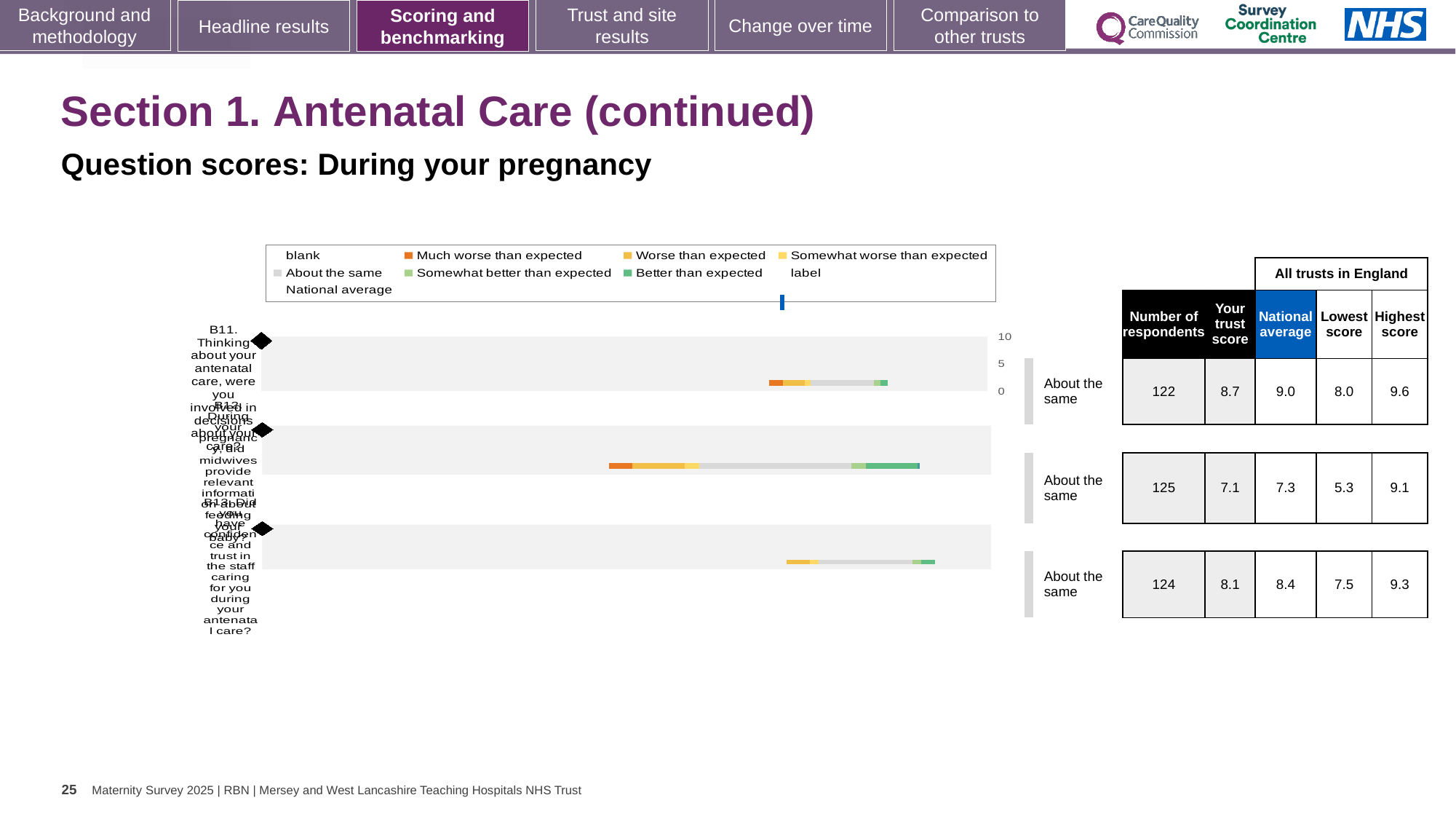
What is the difference between the highest score and the lowest score for question B11? 1.6 What is the national average for question B13? 8.4 What is the trust score for question B12? 7.1 What is the highest value shown on the chart's numeric axis? 10 What is the lowest score across all trusts in England for question B12? 5.3 Which question has the lowest trust score? B12 What kind of chart is shown on the slide? bar chart What is the number of respondents for question B11? 122 Which question has the highest trust score? B11 For question B12, which is larger: the trust score or the national average? National average What benchmark category is shown next to the bar for B11? About the same How many questions (bars) are plotted in the chart? 3